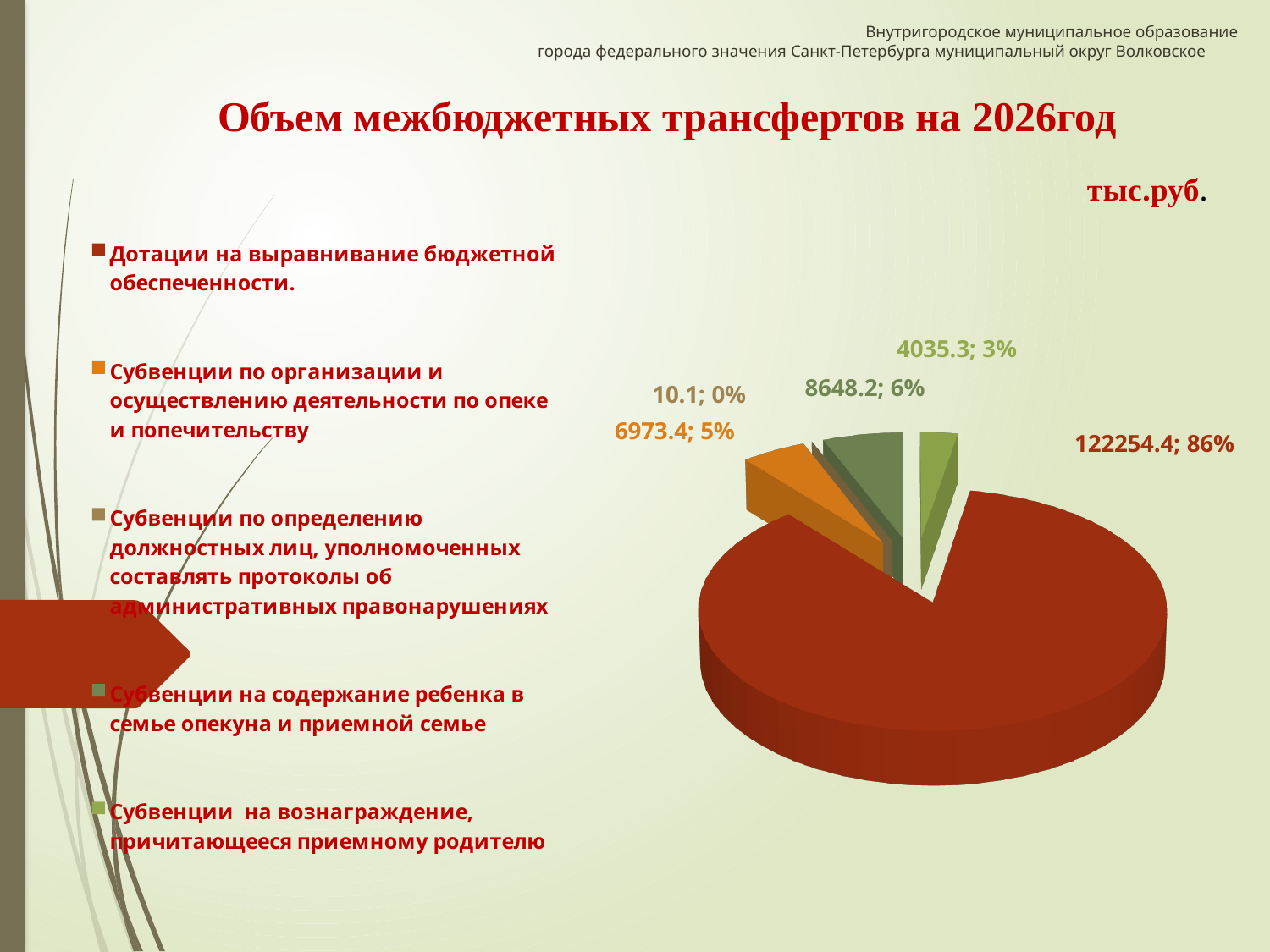
What kind of chart is shown on the slide? Pie chart Which is larger: the slice labelled 8648.2 or the slice labelled 4035.3? 8648.2 How many entries does the legend list? 5 What is the title of the chart on the slide? Объем межбюджетных трансфертов на 2026год Which category has the smallest slice of the pie? Субвенции по определению должностных лиц, уполномоченных составлять протоколы об административных правонарушениях What is the difference between the values 8648.2 and 6973.4 shown on the pie chart? 1674.8 What share of the pie does Субвенции на содержание ребенка в семье опекуна и приемной семье take? 6% How many slices does the pie chart have? 5 What share of the pie does Дотации на выравнивание бюджетной обеспеченности take? 86% What is the value for Дотации на выравнивание бюджетной обеспеченности? 122254.4 What is the value for Субвенции по организации и осуществлению деятельности по опеке и попечительству? 6973.4 Which category has the largest slice of the pie? Дотации на выравнивание бюджетной обеспеченности